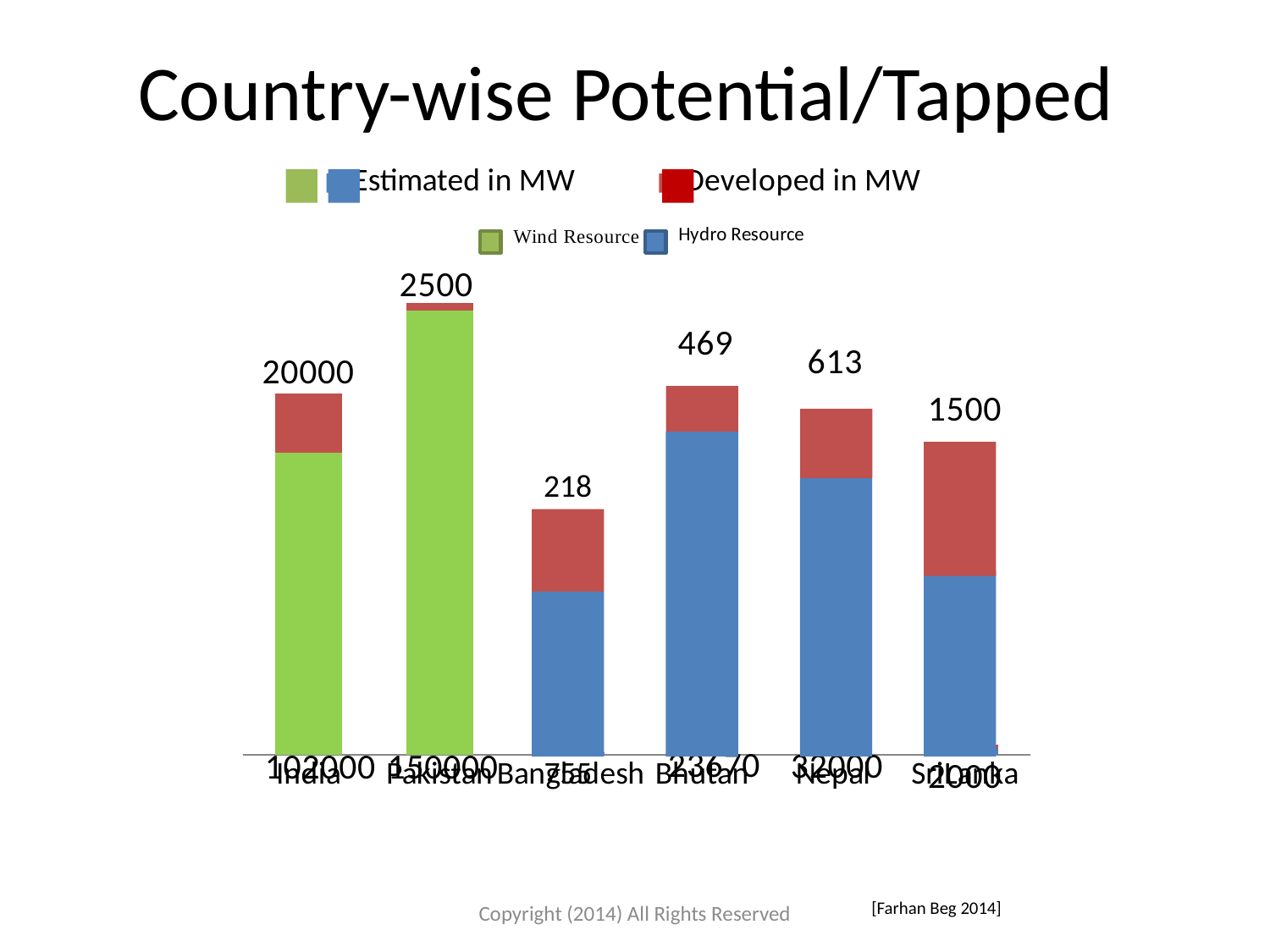
What colour represents Wind Resource in the chart? Green What is the Developed in MW value for Pakistan? 2500 Which country has the highest Developed in MW value? India What is the Developed in MW value for Bangladesh? 218 What is the Developed in MW value for Bhutan? 469 What is the difference between the Developed in MW values for India and Pakistan? 17500 Which country has the lowest Developed in MW value? Bangladesh What is the Developed in MW value for India? 20000 Which has a larger Developed in MW value, Nepal or Bhutan? Nepal What is the Developed in MW value for Nepal? 613 How many countries are shown on the x axis of the chart? 6 What is the Developed in MW value for Sri Lanka? 1500